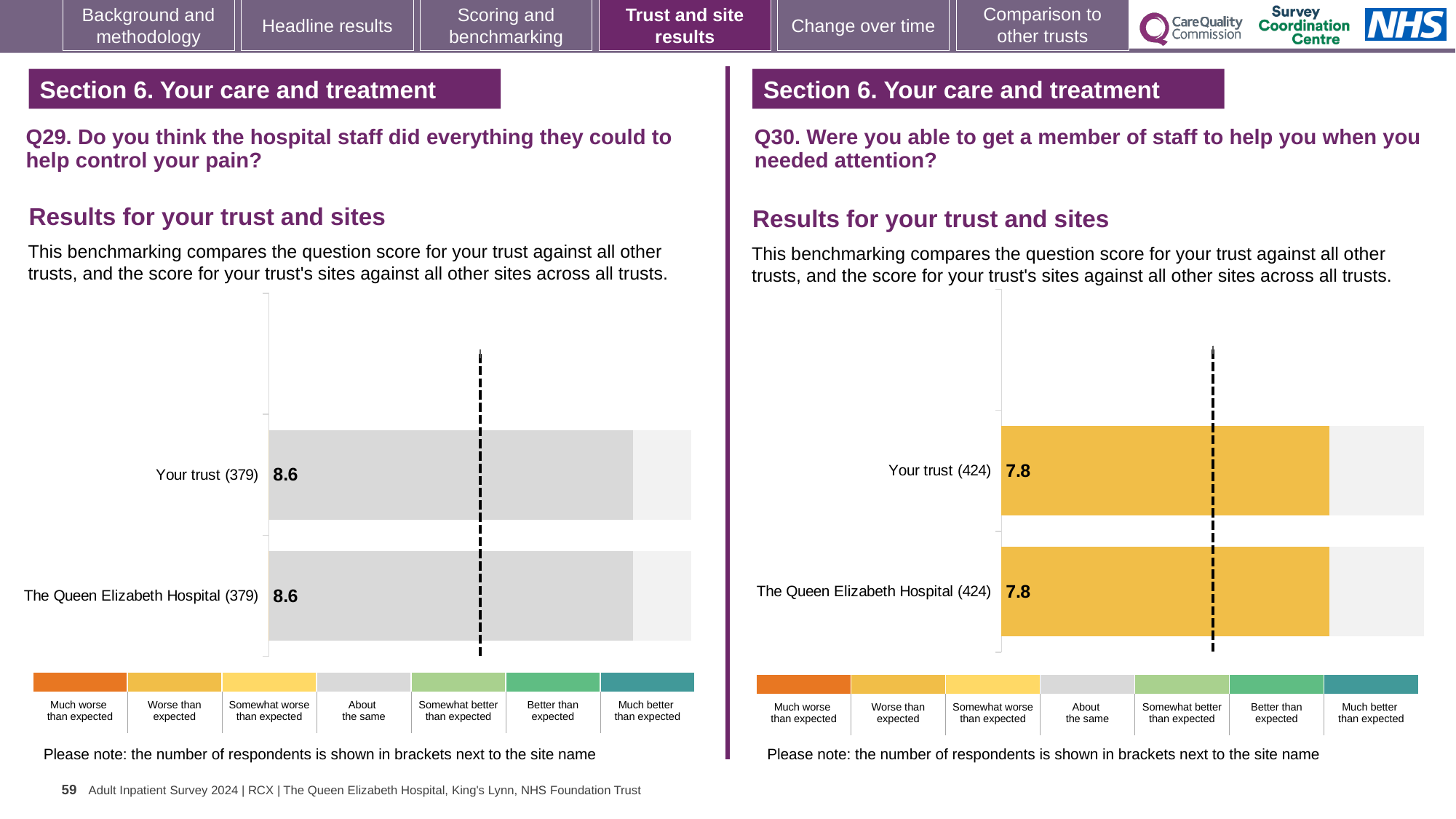
On the Q29 chart (left), what is the difference between the score for Your trust and the score for The Queen Elizabeth Hospital? 0.0 How many bars are plotted on the Q30 chart (right)? 2 On the Q29 chart (left), which benchmark category does the colour of the bars correspond to according to the key? About the same On the Q29 chart (left), what is the score for Your trust (379)? 8.6 On the Q30 chart (right), what is the score for The Queen Elizabeth Hospital (424)? 7.8 On the Q30 chart (right), what is the score for Your trust (424)? 7.8 On the Q29 chart (left), what is the score for The Queen Elizabeth Hospital (379)? 8.6 On the Q30 chart (right), how many respondents are shown in brackets for Your trust? 424 How many bars are plotted on the Q29 chart (left)? 2 On the Q30 chart (right), which benchmark category does the colour of the bars correspond to according to the key? Worse than expected What type of chart is used on the Q29 chart (left)? Bar chart On the Q30 chart (right), what is the difference between the score for Your trust and the score for The Queen Elizabeth Hospital? 0.0